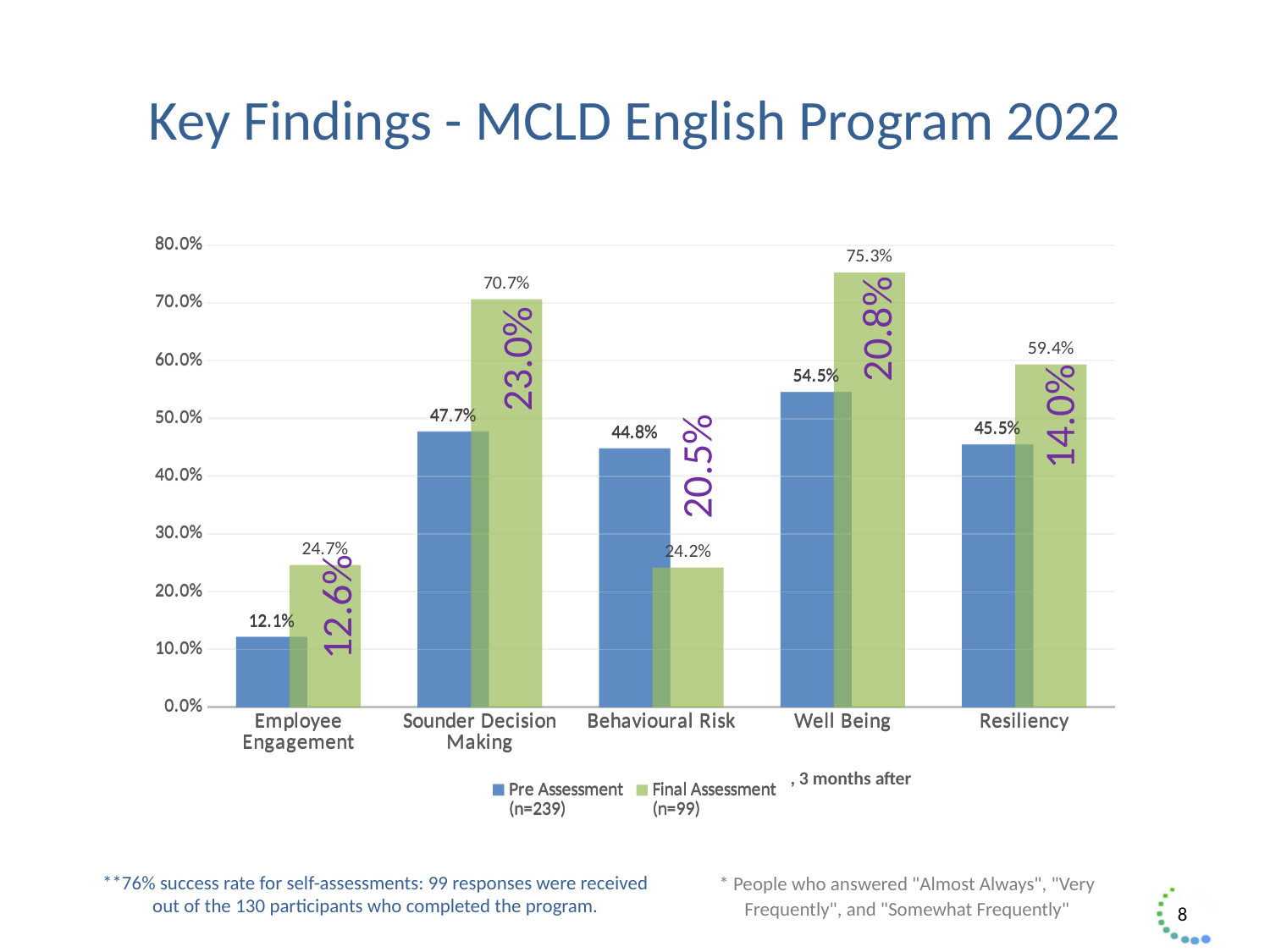
What is the Final Assessment value for Behavioural Risk? 24.2% What is the Pre Assessment value for Resiliency? 45.5% Which category has the lowest Pre Assessment value? Employee Engagement What kind of chart is shown on the slide? Bar chart Which is larger for Behavioural Risk, the Pre Assessment value or the Final Assessment value? Pre Assessment Which category has the highest Final Assessment value? Well Being What is the Final Assessment value for Well Being? 75.3% How many series does the legend list? 2 What is the Pre Assessment value for Employee Engagement? 12.1% What is the difference between the Final Assessment and Pre Assessment values for Sounder Decision Making? 23.0% How many categories are shown on the x axis? 5 Is the Final Assessment value for Resiliency greater or less than 50.0%? greater